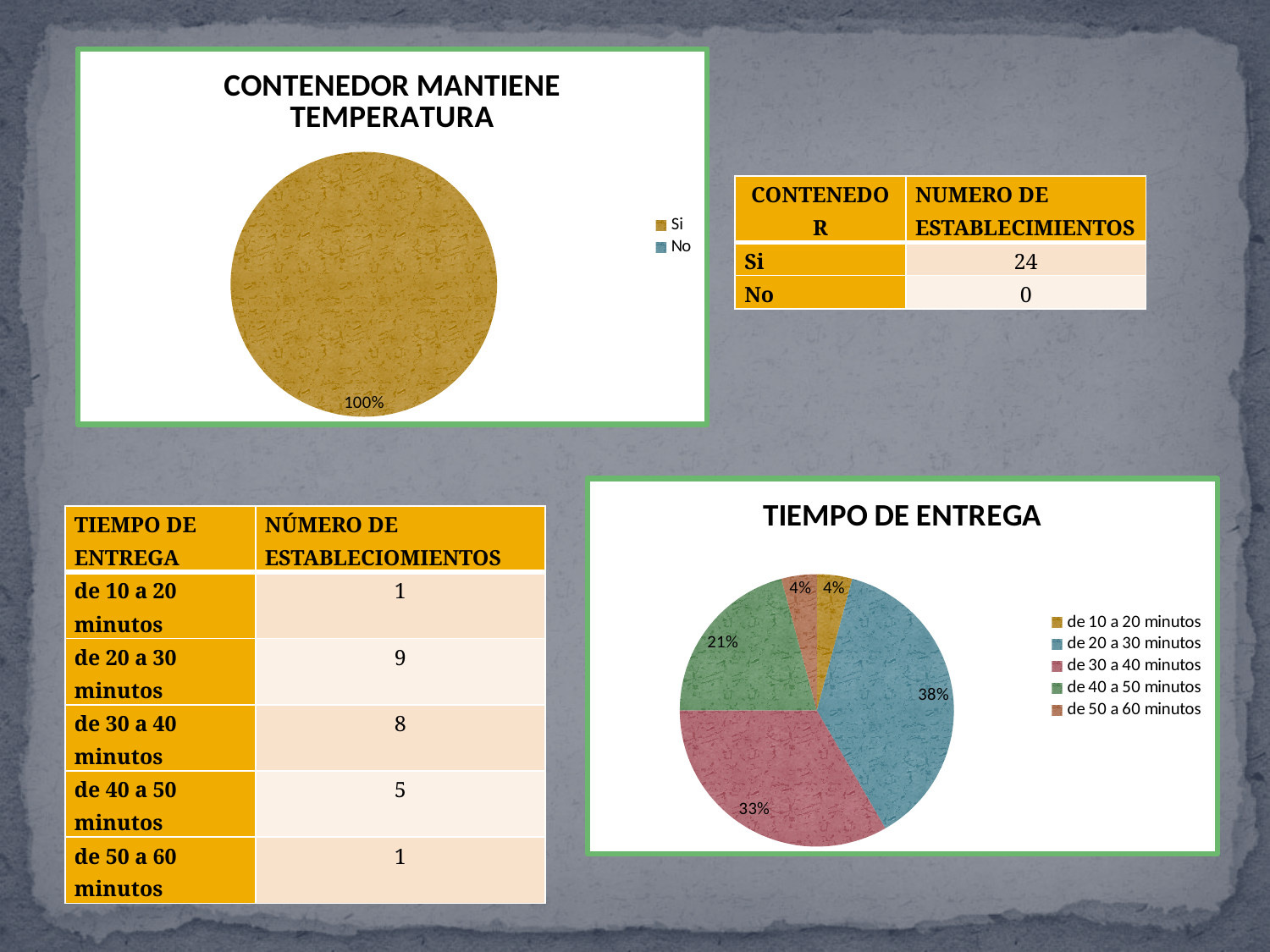
What kind of chart is the "TIEMPO DE ENTREGA" chart? pie chart What kind of chart is the "CONTENEDOR MANTIENE TEMPERATURA" chart? pie chart In the "TIEMPO DE ENTREGA" chart, how many categories does the legend list? 5 In the "TIEMPO DE ENTREGA" chart, what share is shown for de 30 a 40 minutos? 33% In the "TIEMPO DE ENTREGA" chart, which is larger: de 30 a 40 minutos or de 40 a 50 minutos? de 30 a 40 minutos In the "TIEMPO DE ENTREGA" chart, which category has the largest slice? de 20 a 30 minutos In the "CONTENEDOR MANTIENE TEMPERATURA" chart, what percentage is shown for Si? 100% How many entries does the legend of the "CONTENEDOR MANTIENE TEMPERATURA" chart list? 2 In the "TIEMPO DE ENTREGA" chart, what colour is the slice for de 40 a 50 minutos? green In the "TIEMPO DE ENTREGA" chart, what share is shown for de 40 a 50 minutos? 21% In the "TIEMPO DE ENTREGA" chart, what is the difference in percentage points between de 20 a 30 minutos and de 30 a 40 minutos? 5 In the "TIEMPO DE ENTREGA" chart, what share is shown for de 20 a 30 minutos? 38%